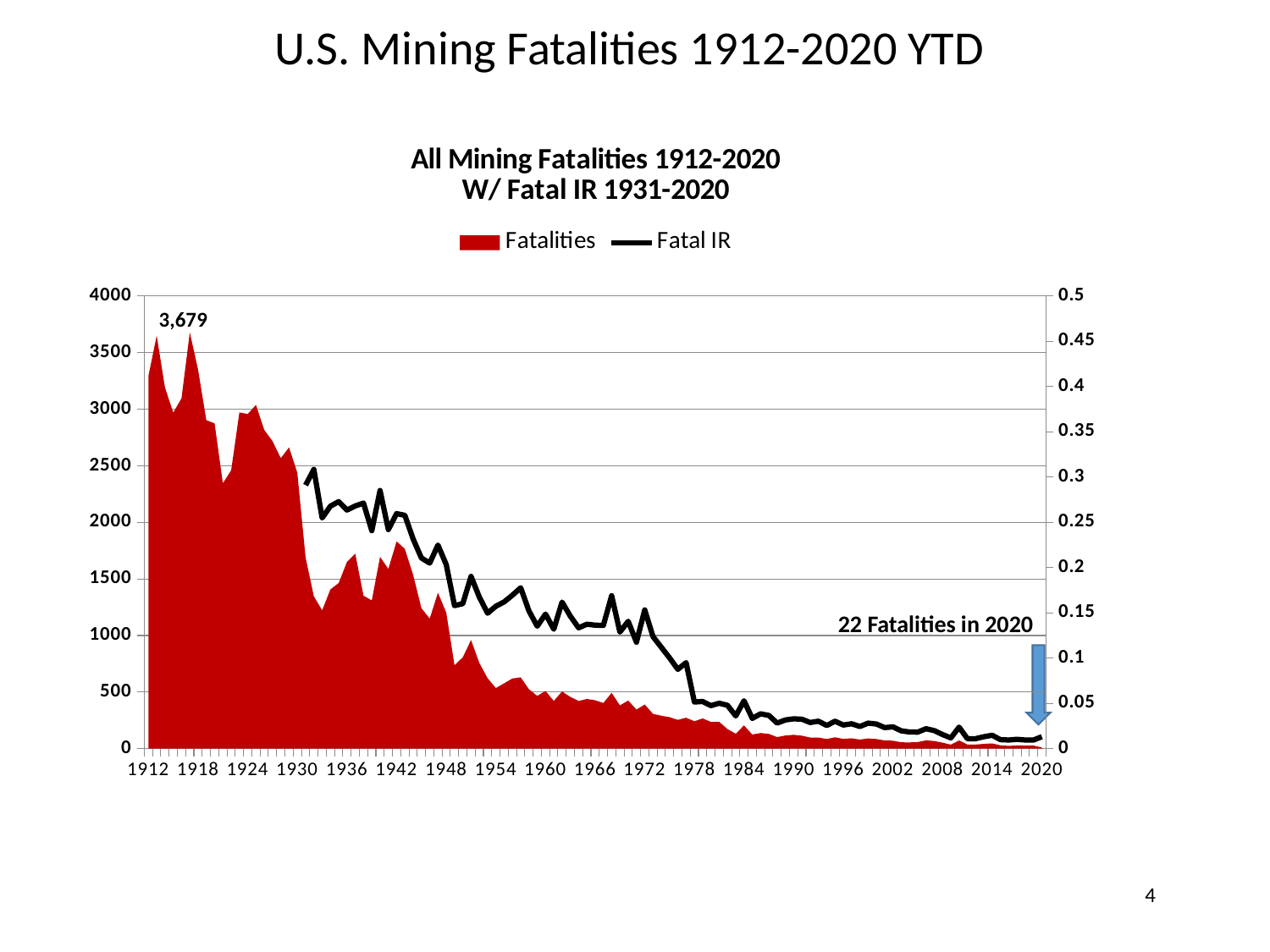
Is the number of fatalities in 1912 greater or less than 3000? greater What is the title of the chart? All Mining Fatalities 1912-2020 W/ Fatal IR 1931-2020 What is the highest fatality value labeled on the chart? 3,679 Which year had more fatalities, 1918 or 1960? 1918 What is the difference between the labeled peak of 3,679 fatalities and the 22 fatalities in 2020? 3,657 How many series does the legend list? 2 Do the fatalities rise or fall over time from 1912 to 2020? fall Is the number of fatalities in 1990 greater or less than 500? less Which year shown has the lowest number of fatalities? 2020 How many fatalities were there in 2020 according to the chart? 22 What are the two series named in the legend? Fatalities and Fatal IR Is the Fatal IR value in 2020 greater or less than 0.05? less